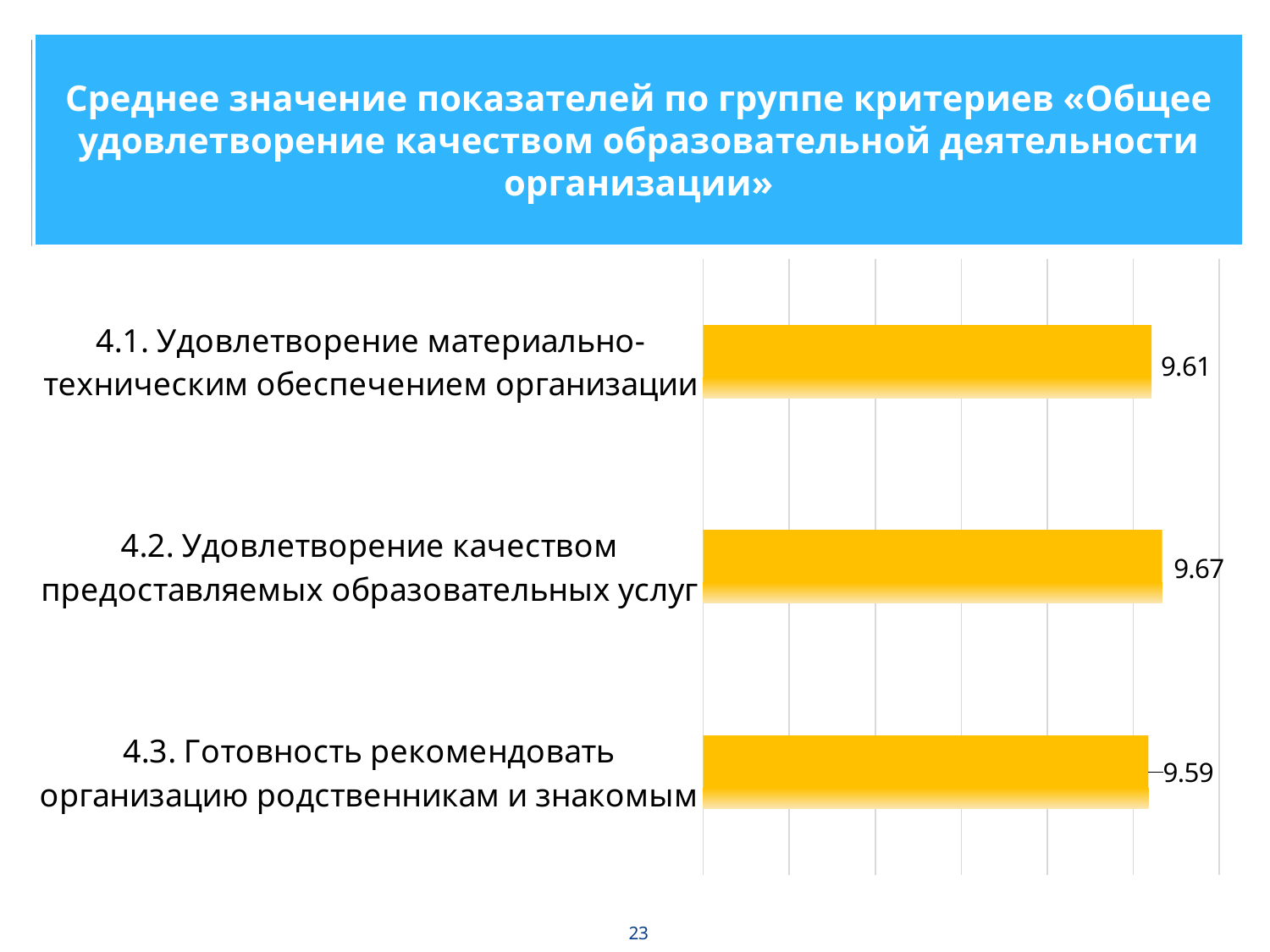
What colour are the bars in the chart? Yellow What kind of chart is shown on the slide? Bar chart What is the title of the slide? Среднее значение показателей по группе критериев «Общее удовлетворение качеством образовательной деятельности организации» Which is larger, the value for 4.1 or the value for 4.3? 4.1 What is the difference between the values for 4.2 and 4.3? 0.08 Which category has the highest value? 4.2. Удовлетворение качеством предоставляемых образовательных услуг Which category has the lowest value? 4.3. Готовность рекомендовать организацию родственникам и знакомым What is the value for "4.1. Удовлетворение материально-техническим обеспечением организации"? 9.61 What is the value for "4.2. Удовлетворение качеством предоставляемых образовательных услуг"? 9.67 What is the value for "4.3. Готовность рекомендовать организацию родственникам и знакомым"? 9.59 How many categories are shown in the chart? 3 What is the difference between the values for 4.2 and 4.1? 0.06